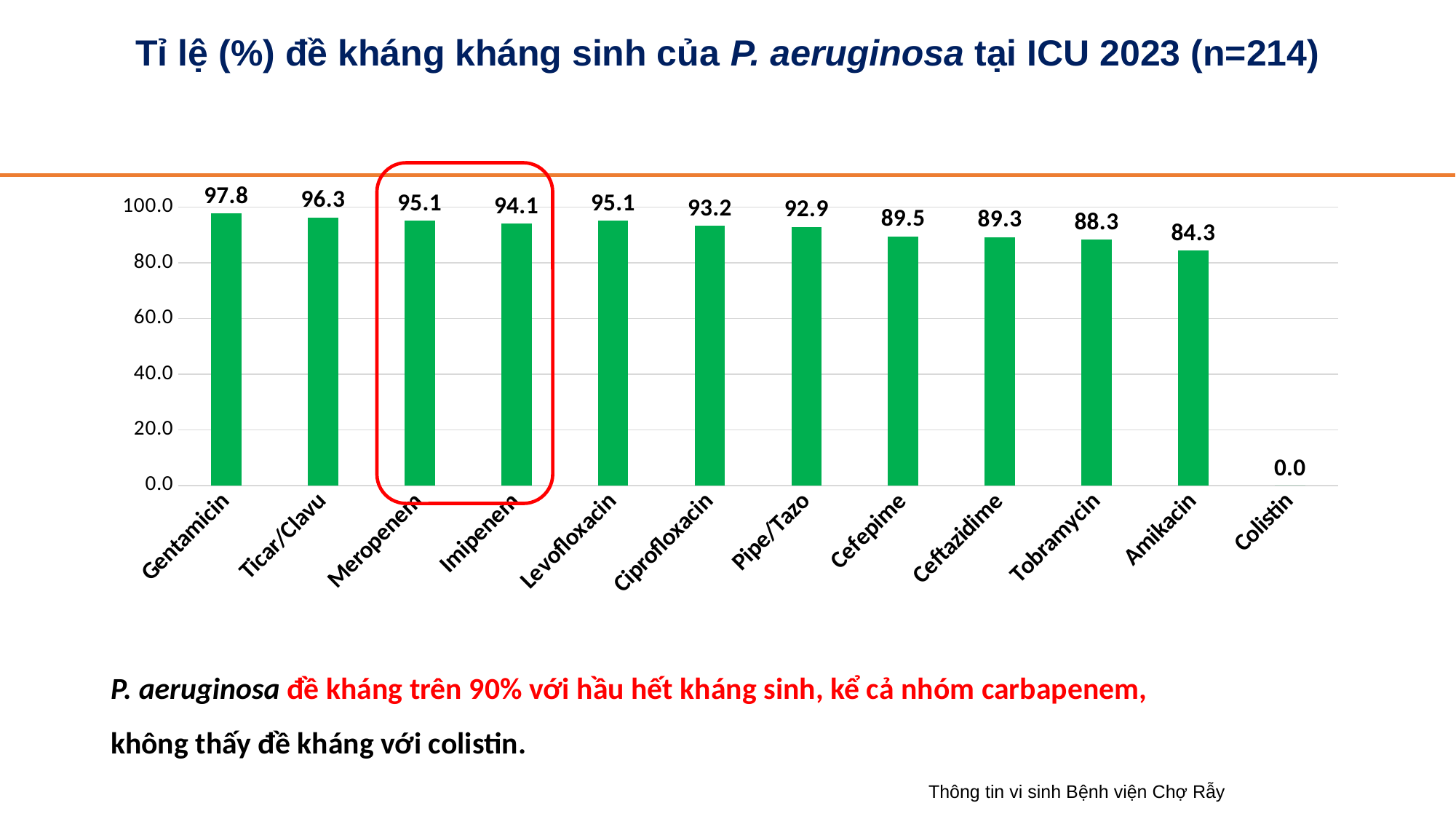
Which antibiotic has the lowest resistance rate? Colistin What is the resistance rate for Gentamicin? 97.8 What is the resistance rate for Amikacin? 84.3 Which has a higher resistance rate, Ticar/Clavu or Tobramycin? Ticar/Clavu How many antibiotics are shown on the x axis? 12 What kind of chart is shown on the slide? bar chart What is the resistance rate for Colistin? 0.0 Which two antibiotics are enclosed by the red outline on the chart? Meropenem and Imipenem What is the resistance rate for Imipenem? 94.1 Which antibiotic has the highest resistance rate? Gentamicin Is the value for Cefepime greater or less than 80.0? greater What is the difference between the resistance rates for Gentamicin and Amikacin? 13.5